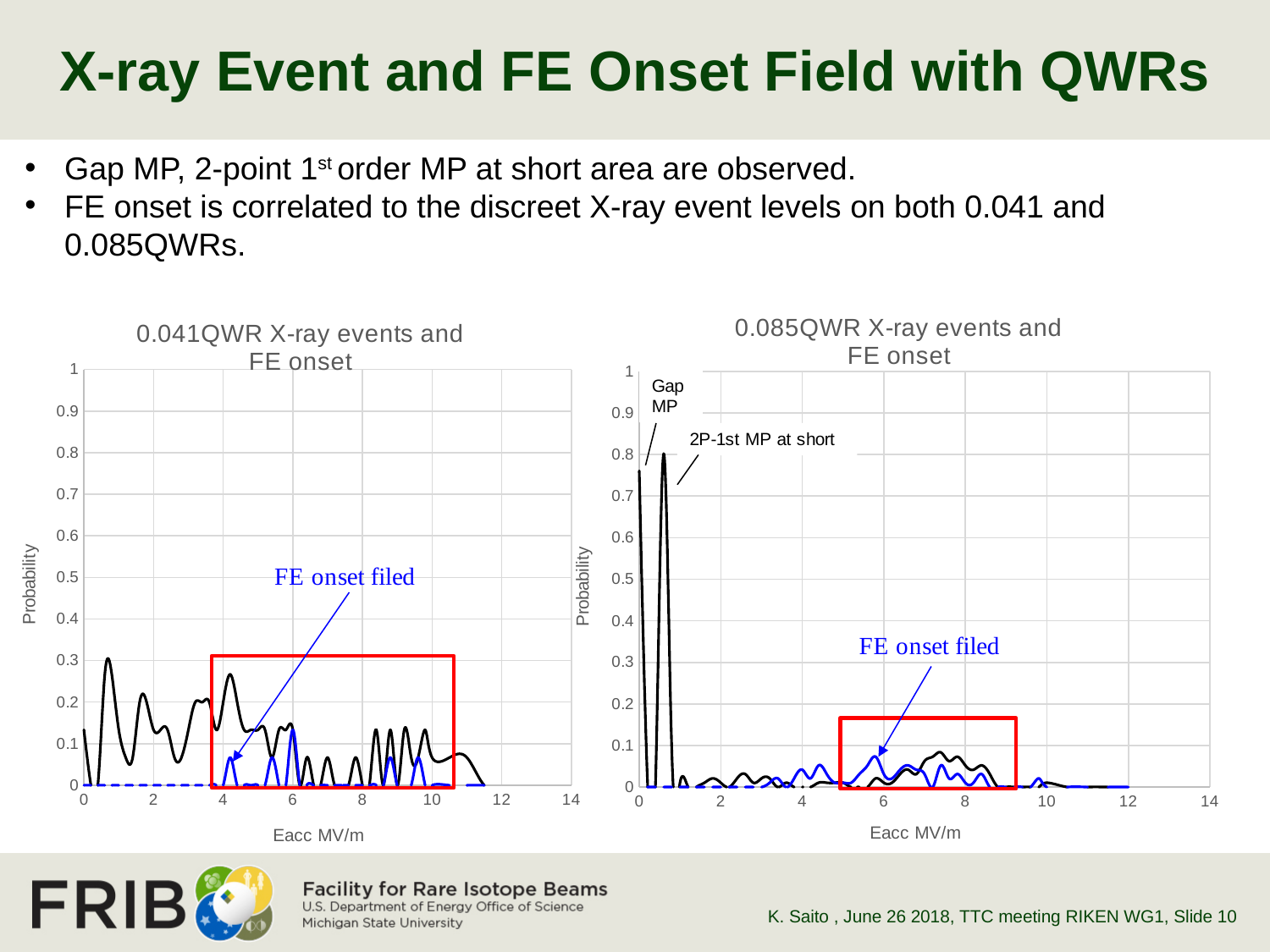
Which chart has the higher maximum probability peak, the 0.041QWR chart or the 0.085QWR chart? 0.085QWR chart What is the maximum value shown on the x axis of the 0.041QWR X-ray events and FE onset chart? 14 How many lines are plotted in the 0.085QWR X-ray events and FE onset chart? 2 In the 0.085QWR X-ray events and FE onset chart, is the peak labelled 2P-1st MP at short greater or less than 0.5? greater What is the y-axis label on the 0.041QWR X-ray events and FE onset chart? Probability In the 0.041QWR X-ray events and FE onset chart, is the highest peak of the black line greater or less than 0.5? less In the 0.085QWR X-ray events and FE onset chart, is the highest point of the blue line greater or less than 0.2? less What kind of chart is the 0.041QWR X-ray events and FE onset chart? line chart What is the x-axis label on the 0.085QWR X-ray events and FE onset chart? Eacc MV/m